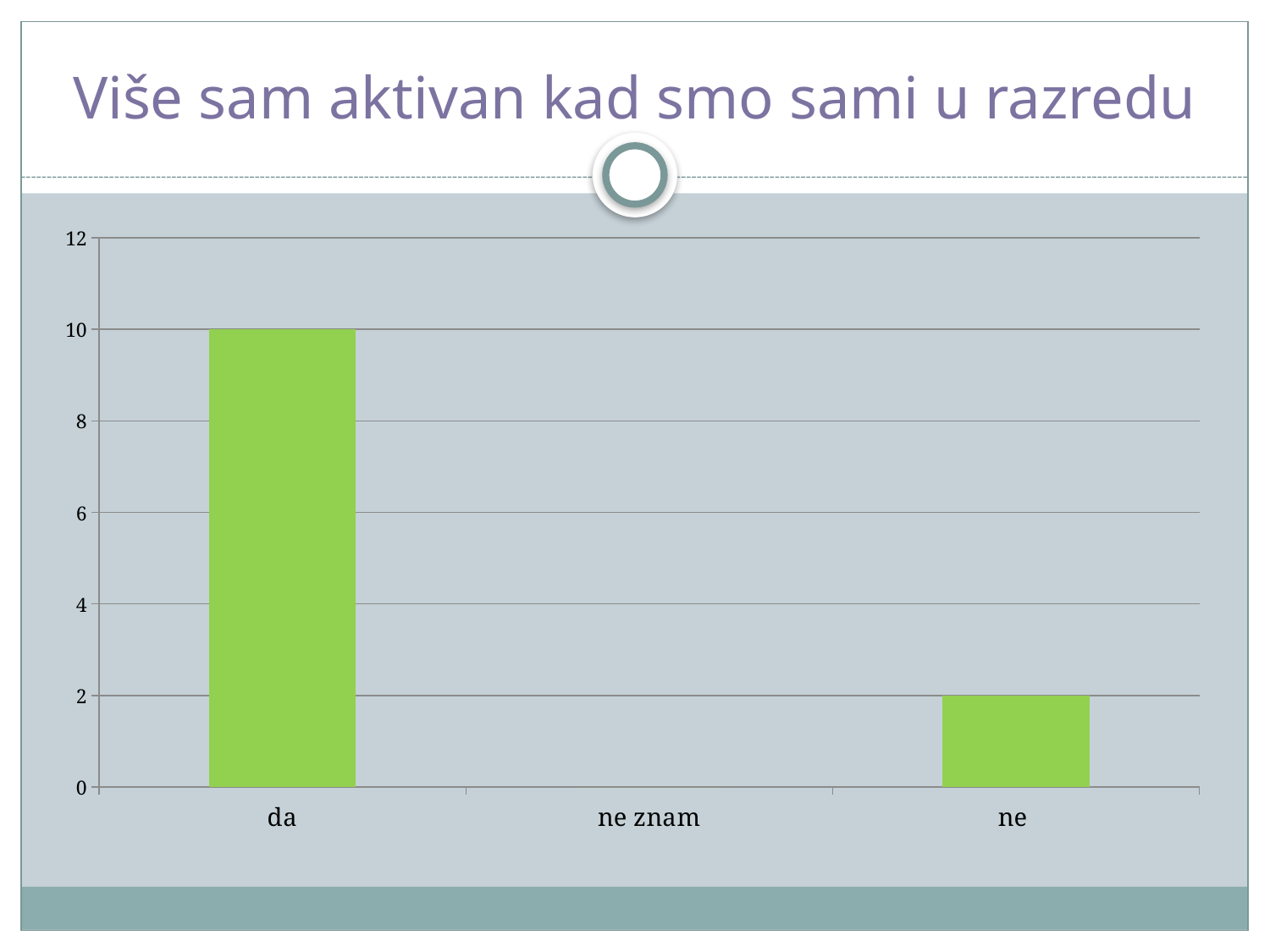
How many categories are shown on the x axis? 3 What is the value for "ne znam"? 0 What is the value for "da"? 10 What is the difference between the values for "da" and "ne"? 8 Which is larger, the value for "da" or the value for "ne"? da Which category has the highest value? da Which category has the lowest value? ne znam What kind of chart is shown on the slide? bar chart Is the value for "ne" greater or less than 4? less What is the title of the slide containing the chart? Više sam aktivan kad smo sami u razredu What is the value for "ne"? 2 Is the value for "da" greater or less than 8? greater